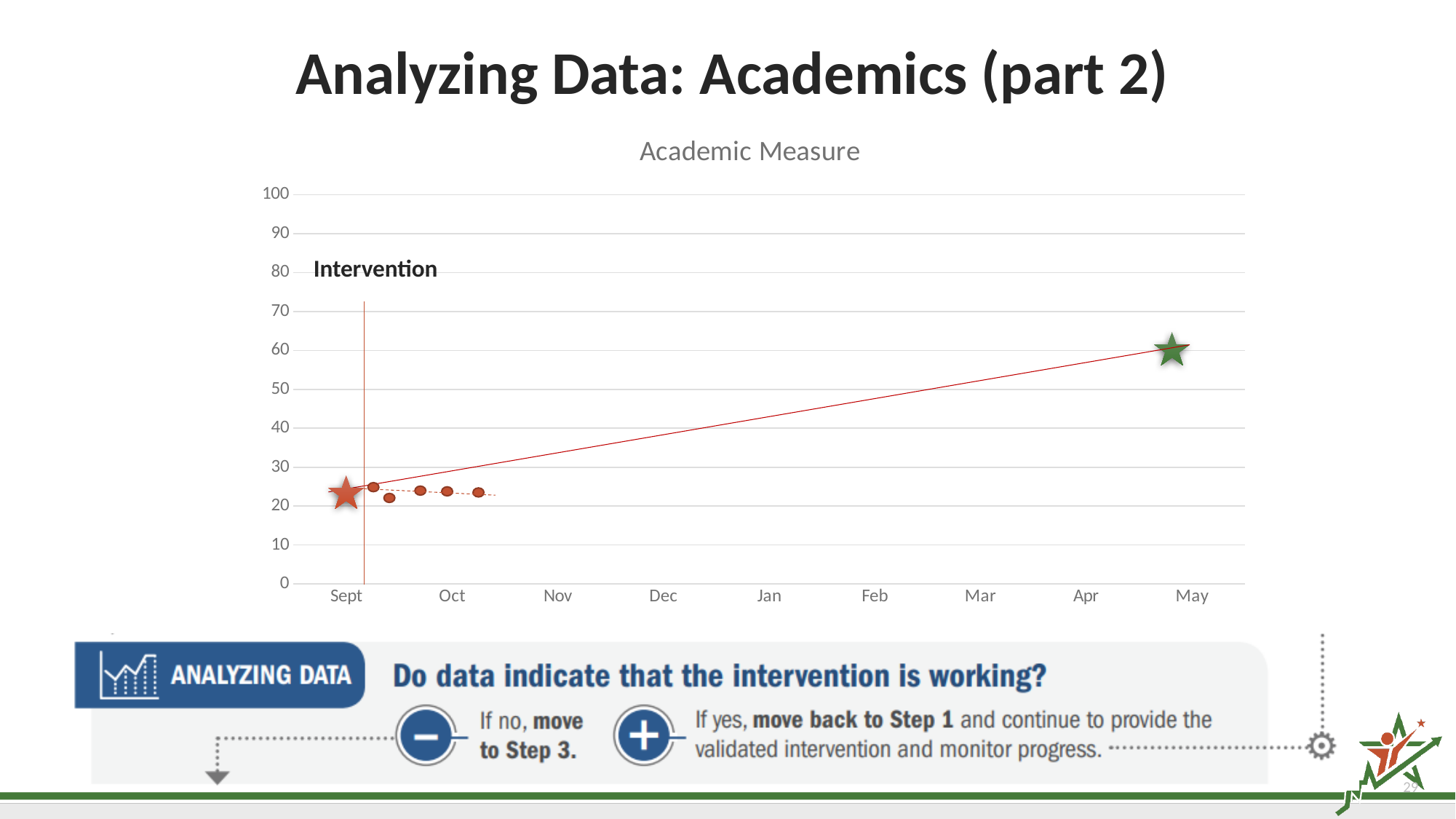
Is the value of the green star at May greater or less than 50? greater Are the plotted data points between Sept and Oct greater or less than 30? less How many months are labelled on the x axis of the chart? 9 What label is written next to the vertical red line near Sept? Intervention Which is higher, the green star at May or the red star at Sept? the green star at May What is the title of the chart? Academic Measure Does the solid red goal line rise or fall from Sept to May? rise Is the value of the green star at May greater or less than 70? less What is the highest value shown on the y axis? 100 What kind of chart is shown on the slide? line chart